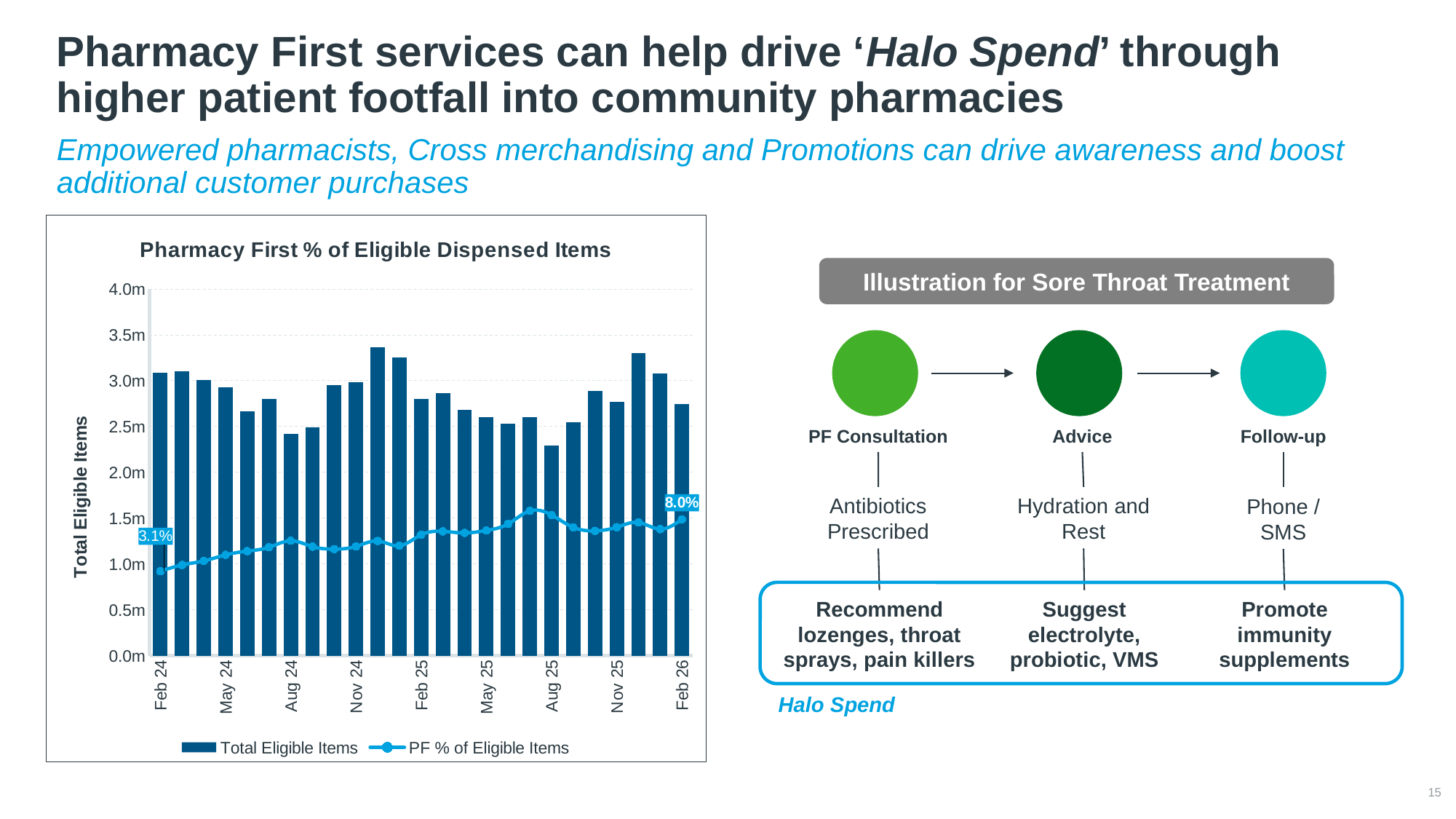
Is the value of Total Eligible Items for Feb 24 greater or less than 2.5m? greater What is the title of the chart on the left of the slide? Pharmacy First % of Eligible Dispensed Items What is the PF % of Eligible Items for Feb 24? 3.1% What is the PF % of Eligible Items for Feb 26? 8.0% What kind of chart is shown on the left of the slide? bar chart with a line How many monthly bars are plotted in the chart? 25 How many series does the chart legend list? 2 Does the PF % of Eligible Items line generally rise or fall from Feb 24 to Feb 26? rise Which is larger, Total Eligible Items for Feb 24 or for Aug 25? Feb 24 Is the value of Total Eligible Items for Aug 25 greater or less than 2.5m? less Is the value of Total Eligible Items for Feb 26 greater or less than 3.0m? less By how many percentage points did the PF % of Eligible Items change from Feb 24 to Feb 26? 4.9 percentage points